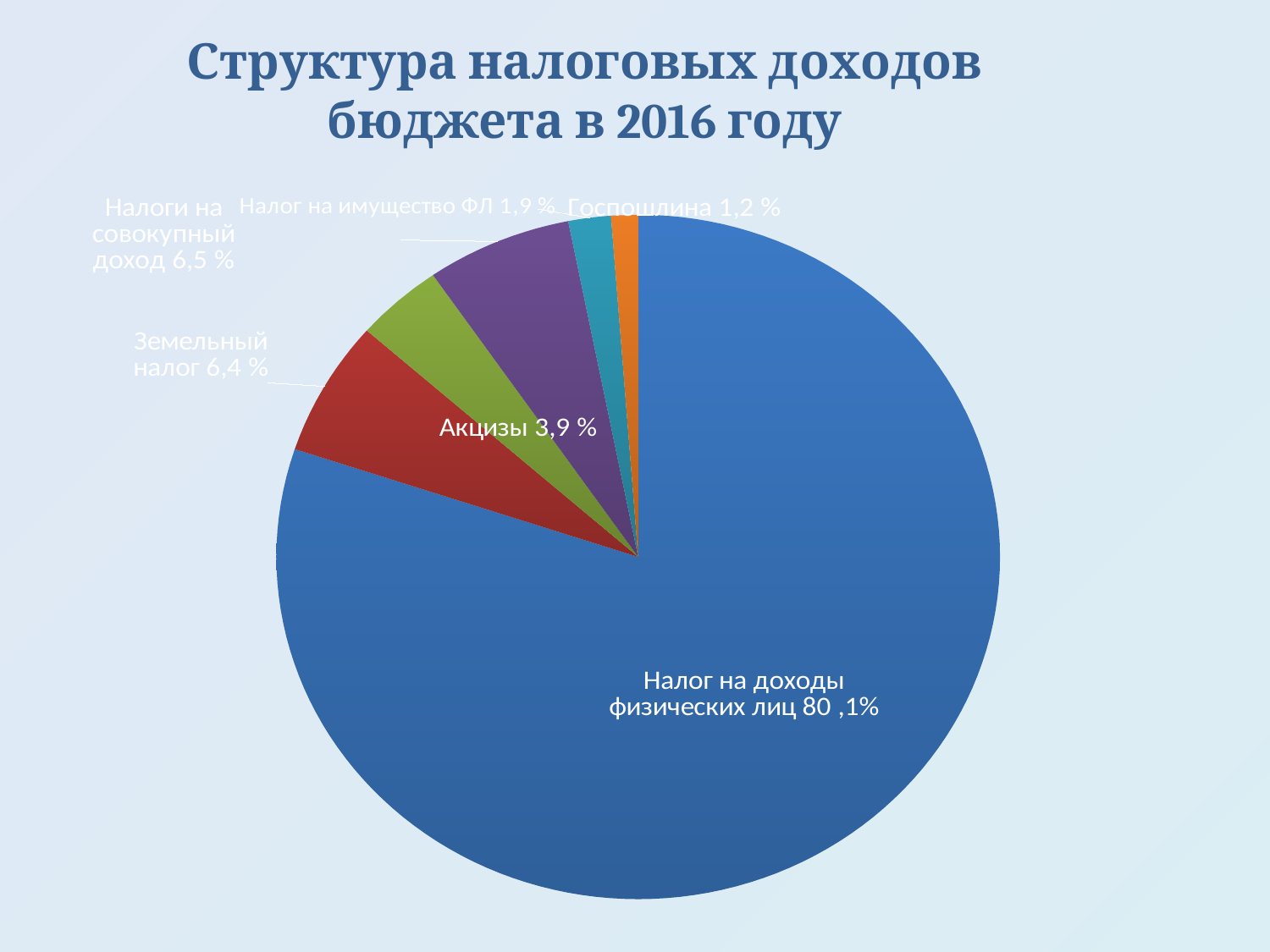
Which category has the largest slice of the pie? Налог на доходы физических лиц What is the value shown for Акцизы? 3,9 % Which is larger, Акцизы or Налог на имущество ФЛ? Акцизы What share of the pie does Налог на доходы физических лиц have? 80,1% What type of chart is shown on the slide? Pie chart What is the difference between the shares of Налог на доходы физических лиц and Налоги на совокупный доход? 73,6 % What is the value shown for Налоги на совокупный доход? 6,5 % What is the value shown for Земельный налог? 6,4 % What is the title of the chart on the slide? Структура налоговых доходов бюджета в 2016 году Which category has the smallest slice of the pie? Госпошлина What is the value shown for Госпошлина? 1,2 % How many slices does the pie chart have? 6